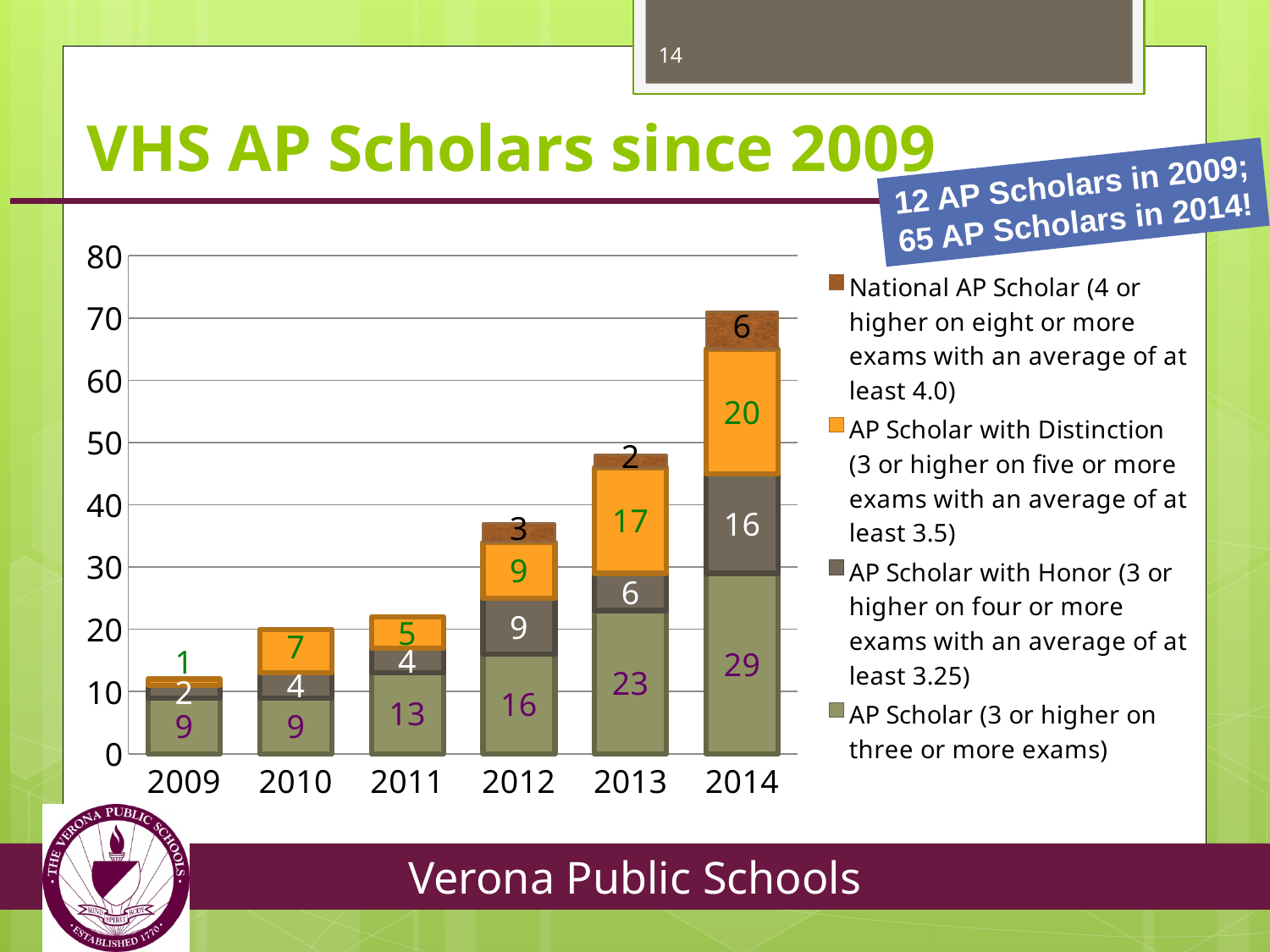
What is the AP Scholar with Distinction value for 2013? 17 How many series does the chart's legend list? 4 What is the National AP Scholar value for 2012? 3 What is the total of the stacked bar for 2013? 48 How many years are shown on the x axis of the chart? 6 Do the AP Scholar values rise or fall from 2009 to 2014? Rise What kind of chart is shown on the slide? Stacked bar chart In 2013, which is larger: AP Scholar with Distinction or AP Scholar with Honor? AP Scholar with Distinction What is the difference between the AP Scholar value for 2013 and the AP Scholar value for 2009? 14 Which year has the lowest AP Scholar with Distinction value? 2009 What is the AP Scholar value for 2014? 29 Which year has the highest AP Scholar with Honor value? 2014